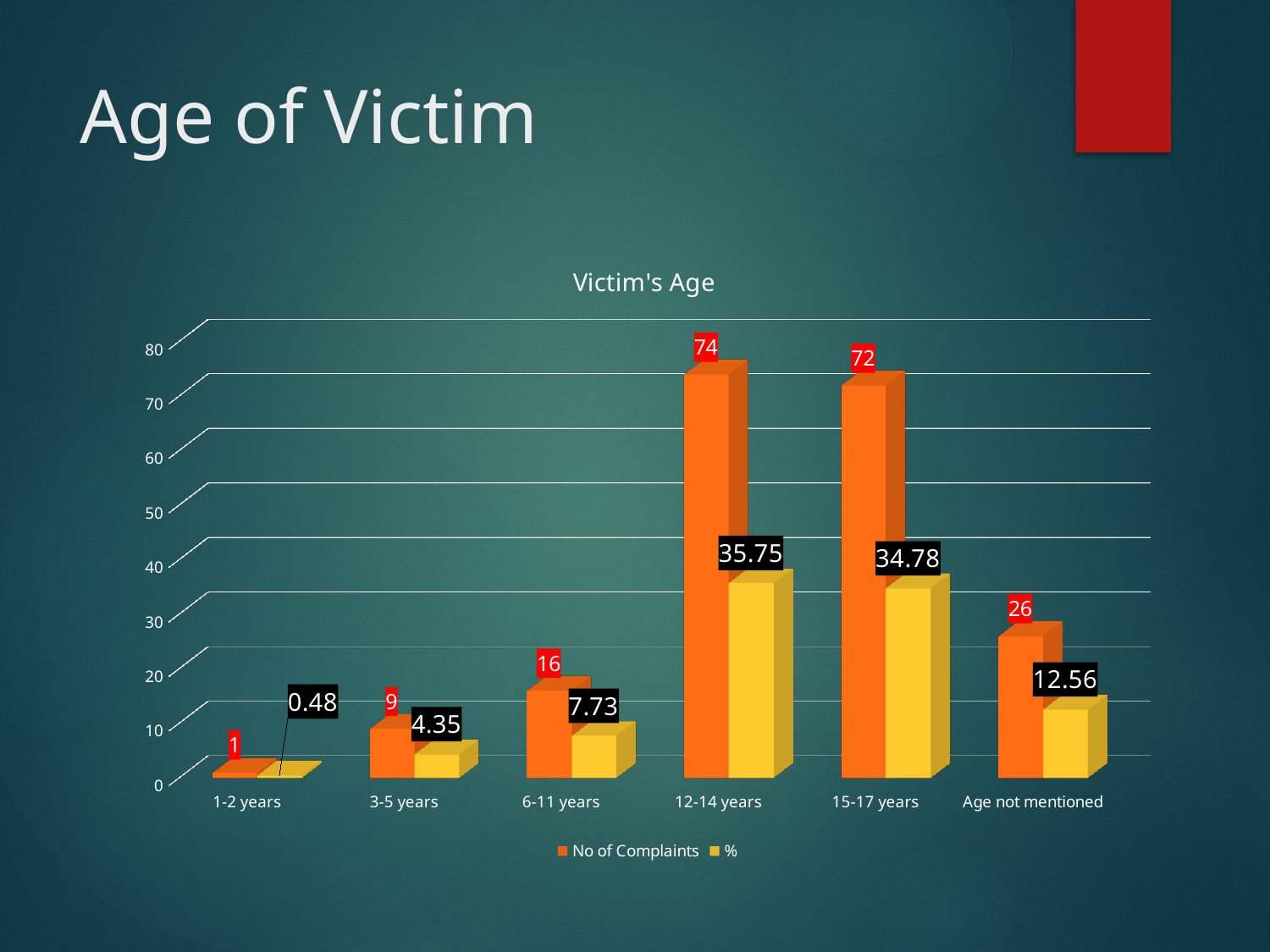
What is the title of the chart? Victim's Age Which has more complaints: the 3-5 years group or the 6-11 years group? 6-11 years What is the number of complaints for the 12-14 years age group? 74 How many series does the legend list? 2 What kind of chart is shown on the slide? Bar chart What is the number of complaints for the 'Age not mentioned' category? 26 What is the difference in number of complaints between the 12-14 years and 15-17 years groups? 2 Which age group has the highest number of complaints? 12-14 years How many age categories are shown on the x axis? 6 What percentage is shown for the 15-17 years age group? 34.78 What is the percentage value for the 1-2 years age group? 0.48 Which age group has the lowest number of complaints? 1-2 years